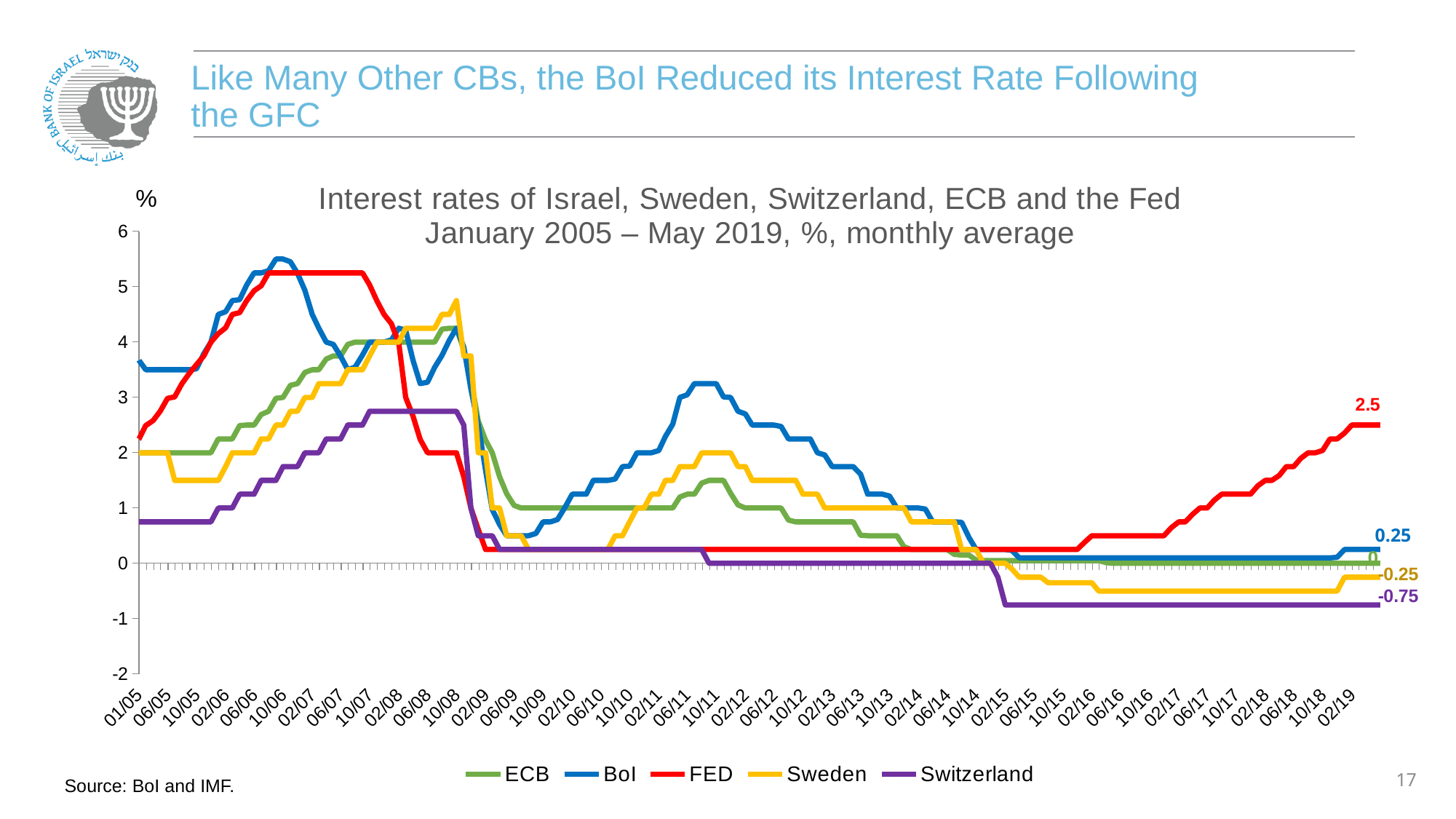
Which series has the lowest interest rate at the end of the period shown (May 2019)? Switzerland How many series does the legend list? 5 Does the FED series rise or fall between 02/16 and 02/19? Rise What is the final labelled value for the Switzerland series at the right end of the chart? -0.75 What is the final labelled value for the BoI series at the right end of the chart? 0.25 What is the difference between the final labelled values of the FED and BoI series? 2.25 What is the final labelled value for the Sweden series at the right end of the chart? -0.25 What kind of chart is shown on the slide? Line chart At the end of the period, which is higher: the Sweden rate or the Switzerland rate? Sweden Is the peak value of the BoI series around 10/06 greater or less than 5? greater What is the final labelled value for the FED series at the right end of the chart? 2.5 Which series has the highest interest rate at the end of the period shown (May 2019)? FED